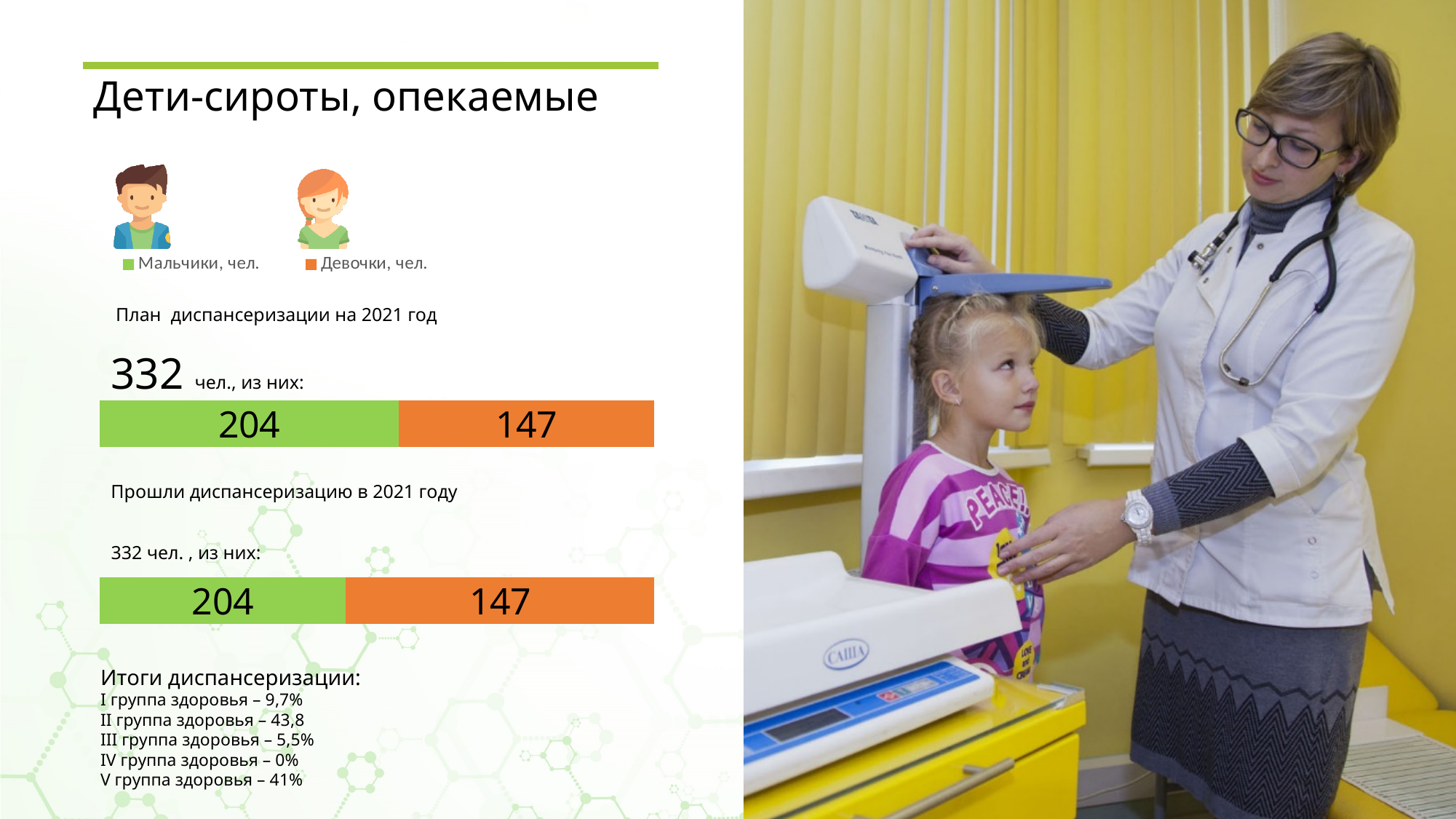
On the chart 'Прошли диспансеризацию в 2021 году', which is larger: Мальчики or Девочки? Мальчики What colour represents Мальчики, чел. in the legend? Green On the chart 'План диспансеризации на 2021 год', what is the value for Девочки, чел.? 147 On the chart 'Прошли диспансеризацию в 2021 году', what is the value for Девочки, чел.? 147 On the chart 'План диспансеризации на 2021 год', what is the value for Мальчики, чел.? 204 What colour represents Девочки, чел. in the legend? Orange On the chart 'План диспансеризации на 2021 год', which is larger: Мальчики or Девочки? Мальчики What kind of chart is 'План диспансеризации на 2021 год'? Stacked bar chart How many series does the legend list for the charts on the slide? 2 On the chart 'Прошли диспансеризацию в 2021 году', what is the difference between the values for Мальчики and Девочки? 57 On the chart 'План диспансеризации на 2021 год', what is the difference between the values for Мальчики and Девочки? 57 On the chart 'Прошли диспансеризацию в 2021 году', what is the value for Мальчики, чел.? 204